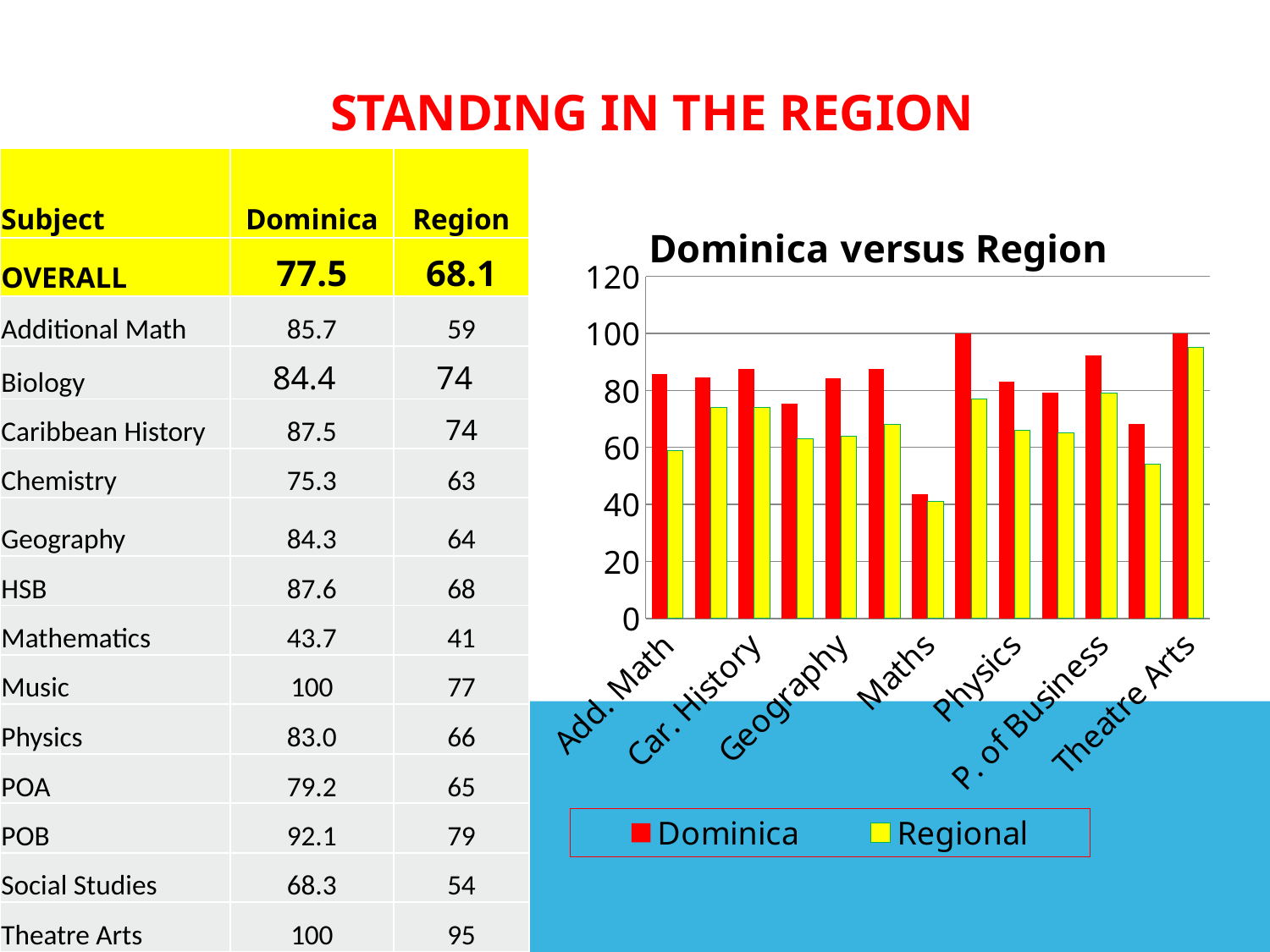
How many series does the chart legend list? 2 What is the title of the chart? Dominica versus Region Is the Dominica value for Maths greater or less than 60? less Is the Regional value for Theatre Arts greater or less than 80? greater For Add. Math, which is larger, the Dominica value or the Regional value? Dominica Which subject has the lowest Dominica value in the chart? Maths Is the Dominica value for Add. Math greater or less than 80? greater What kind of chart is shown on the slide? bar chart Which subject has the highest Regional value in the chart? Theatre Arts What is the highest value shown on the chart's vertical axis? 120 Which colour represents the Regional series in the chart? yellow